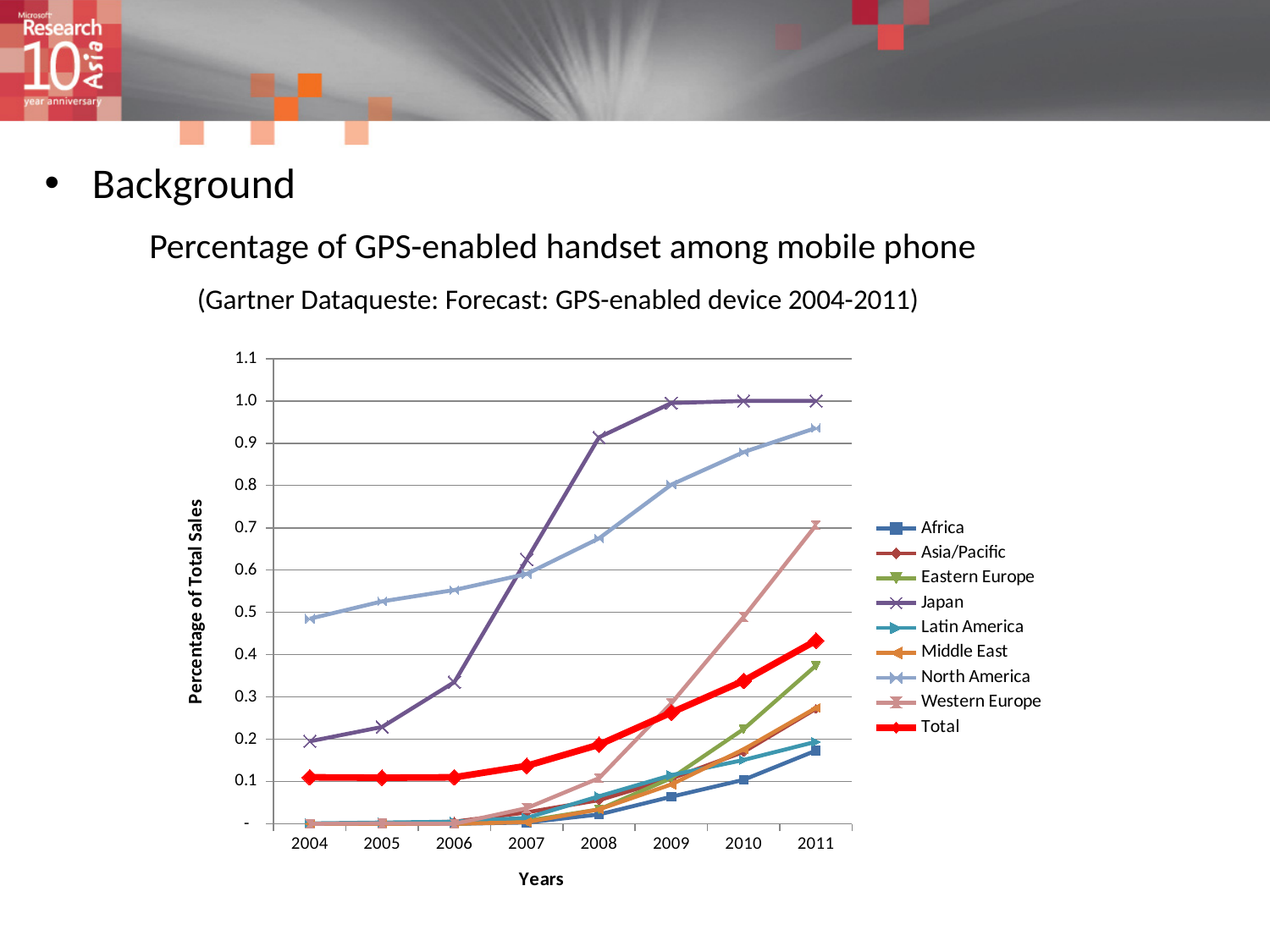
Is the value for Japan in 2008 greater or less than 0.8? greater Which region has the highest value in 2011? Japan Does the Total series rise or fall from 2004 to 2011? rise What is the label of the y axis? Percentage of Total Sales In 2006, which is higher: Japan or North America? North America In 2011, which is higher: Western Europe or Total? Western Europe What type of chart is shown on the slide? line chart Which region has the highest value in 2004? North America How many series does the legend list? 9 Is the value for Africa in 2011 greater or less than 0.2? less How many years are shown on the x axis? 8 Is the value for North America in 2004 greater or less than 0.4? greater